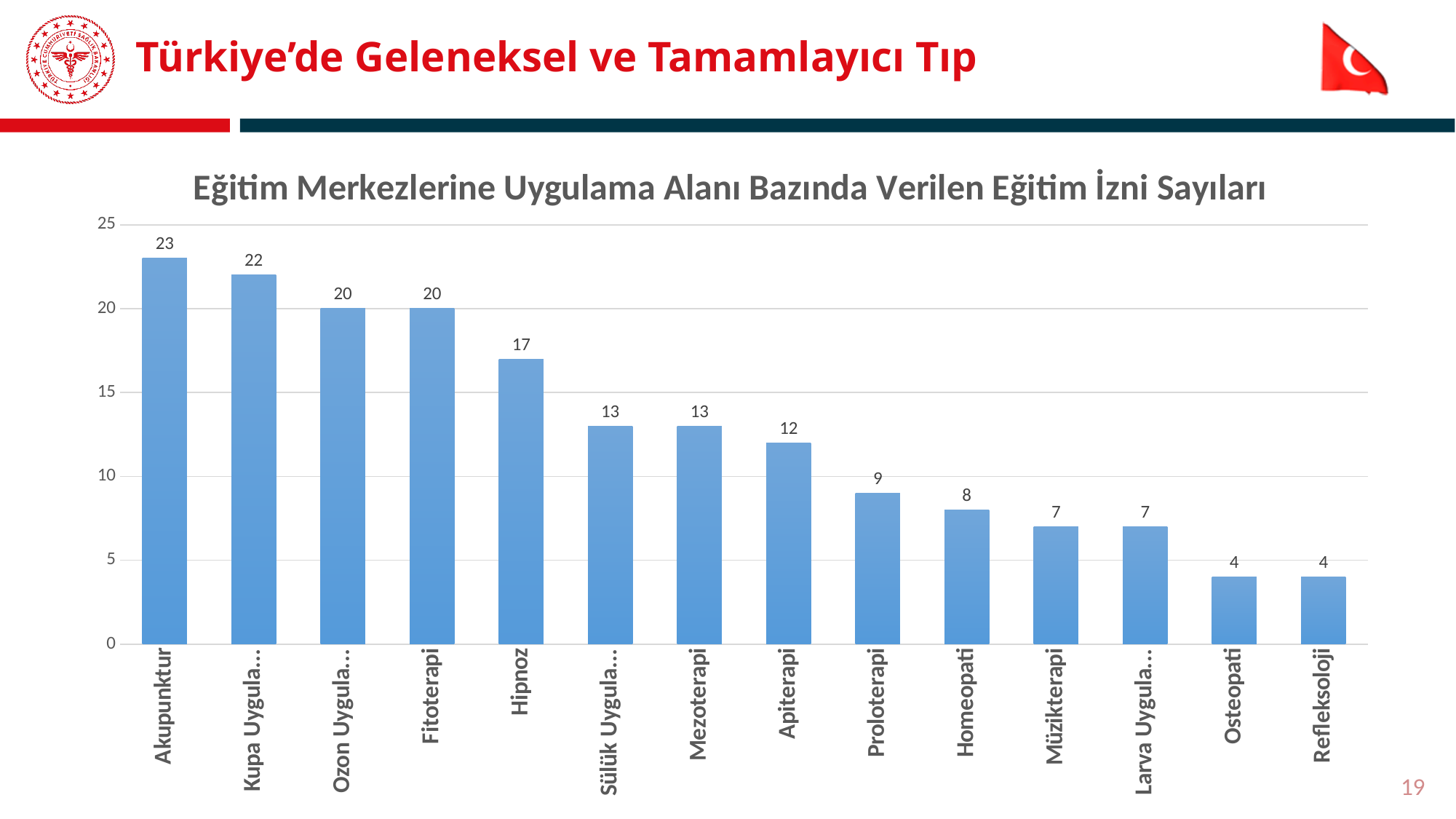
What is the title of the chart? Eğitim Merkezlerine Uygulama Alanı Bazında Verilen Eğitim İzni Sayıları What is the difference between the values for Mezoterapi and Proloterapi? 4 What kind of chart is shown on the slide? bar chart Is the value for Proloterapi greater or less than 10? less Which is larger, the value for Hipnoz or the value for Müzikterapi? Hipnoz What is the value for Apiterapi? 12 What is the value for Homeopati? 8 Which category has the highest value? Akupunktur What is the value for Akupunktur? 23 What is the difference between the values for Akupunktur and Fitoterapi? 3 How many categories are shown in the chart? 14 What is the value for Hipnoz? 17